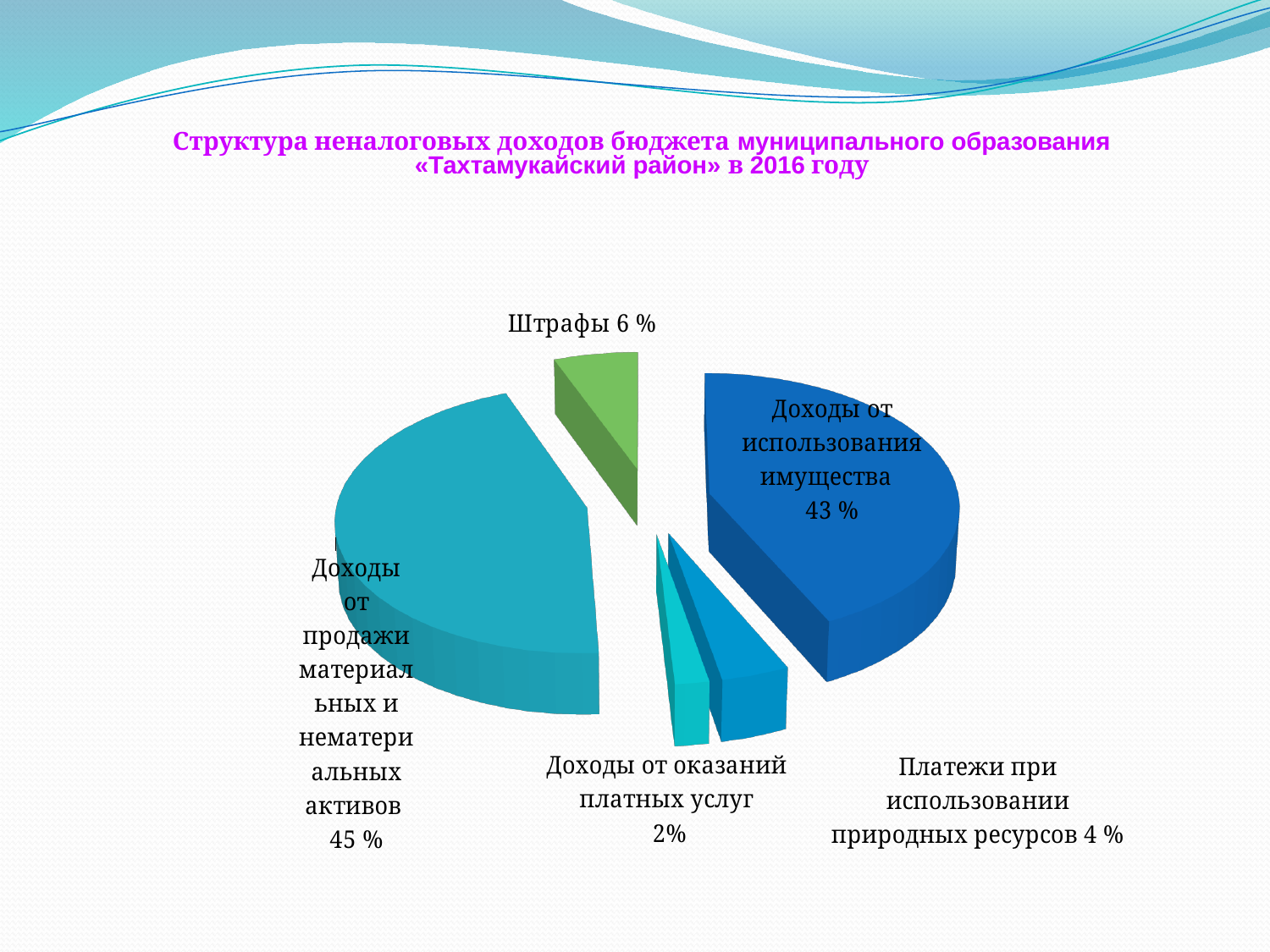
What share of non-tax revenues comes from «Доходы от использования имущества»? 43 % What is the difference in percentage points between «Доходы от продажи материальных и нематериальных активов» and «Доходы от использования имущества»? 2 What share is shown for «Платежи при использовании природных ресурсов»? 4 % What share is shown for «Доходы от оказаний платных услуг»? 2% What share is shown for «Штрафы»? 6 % Which category has the largest share of the pie? Доходы от продажи материальных и нематериальных активов Which is larger: the share for «Штрафы» or the share for «Платежи при использовании природных ресурсов»? Штрафы What kind of chart is shown on the slide? pie chart How many slices does the pie chart have? 5 What share is shown for «Доходы от продажи материальных и нематериальных активов»? 45 % What is the title of the chart on the slide? Структура неналоговых доходов бюджета муниципального образования «Тахтамукайский район» в 2016 году Which category has the smallest share of the pie? Доходы от оказаний платных услуг